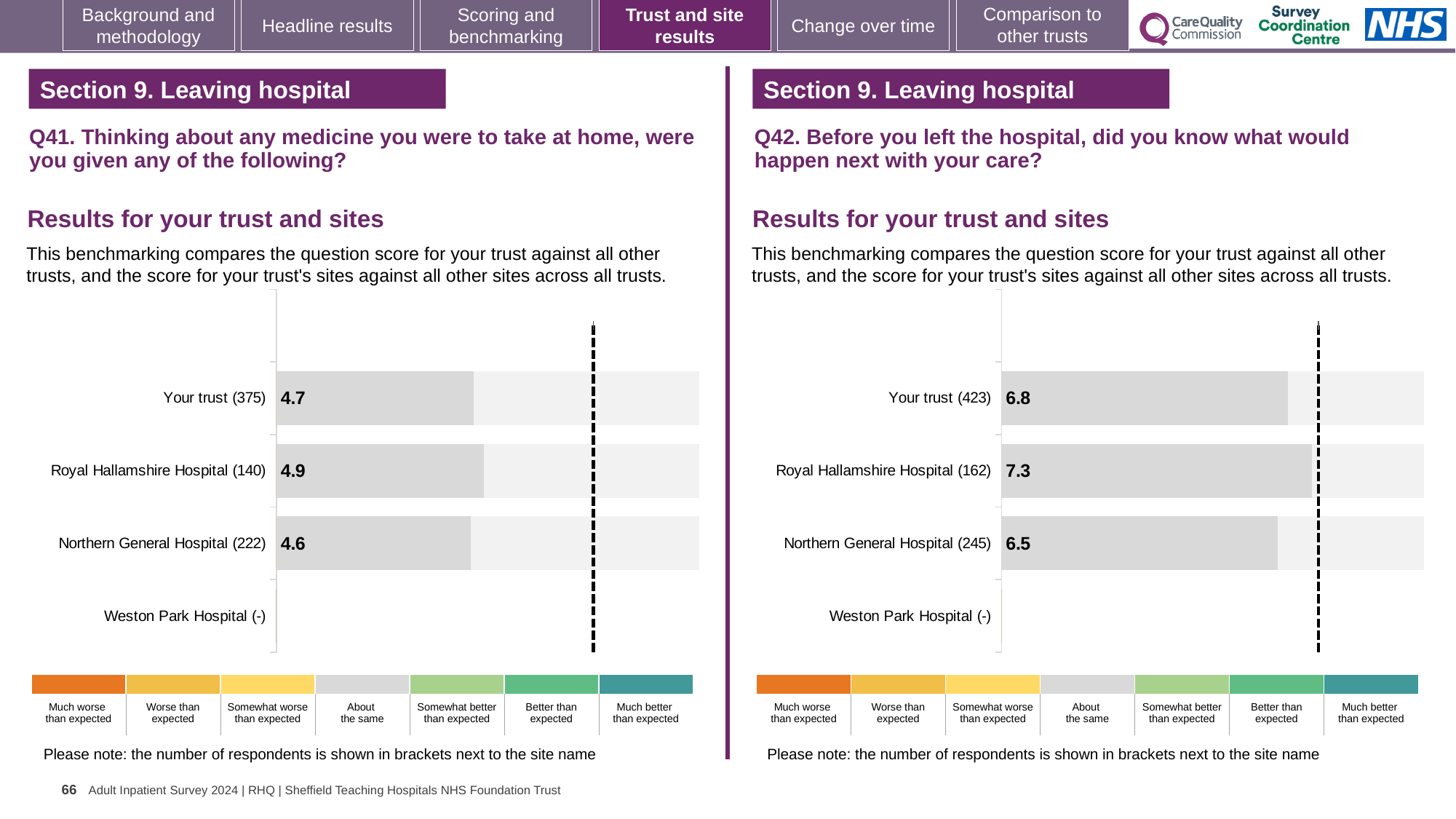
In the Q41 chart on the left, which site with a score shown has the lowest score? Northern General Hospital In the Q41 chart on the left, what is the score for Royal Hallamshire Hospital? 4.9 In the Q41 chart on the left, what is the score for Northern General Hospital? 4.6 In the Q42 chart on the right, what is the difference between the scores for Royal Hallamshire Hospital and Northern General Hospital? 0.8 What kind of chart is used in the Q41 chart on the left? Bar chart In the Q42 chart on the right, what is the score for Royal Hallamshire Hospital? 7.3 In the Q41 chart on the left, which is larger: the score for Royal Hallamshire Hospital or the score for Your trust? Royal Hallamshire Hospital In the Q42 chart on the right, which site has the highest score? Royal Hallamshire Hospital In the Q42 chart on the right, what is the score for Northern General Hospital? 6.5 In the Q41 chart on the left, what is the score for Your trust? 4.7 How many respondents are shown in brackets for Northern General Hospital in the Q42 chart on the right? 245 In the Q42 chart on the right, what is the score for Your trust? 6.8